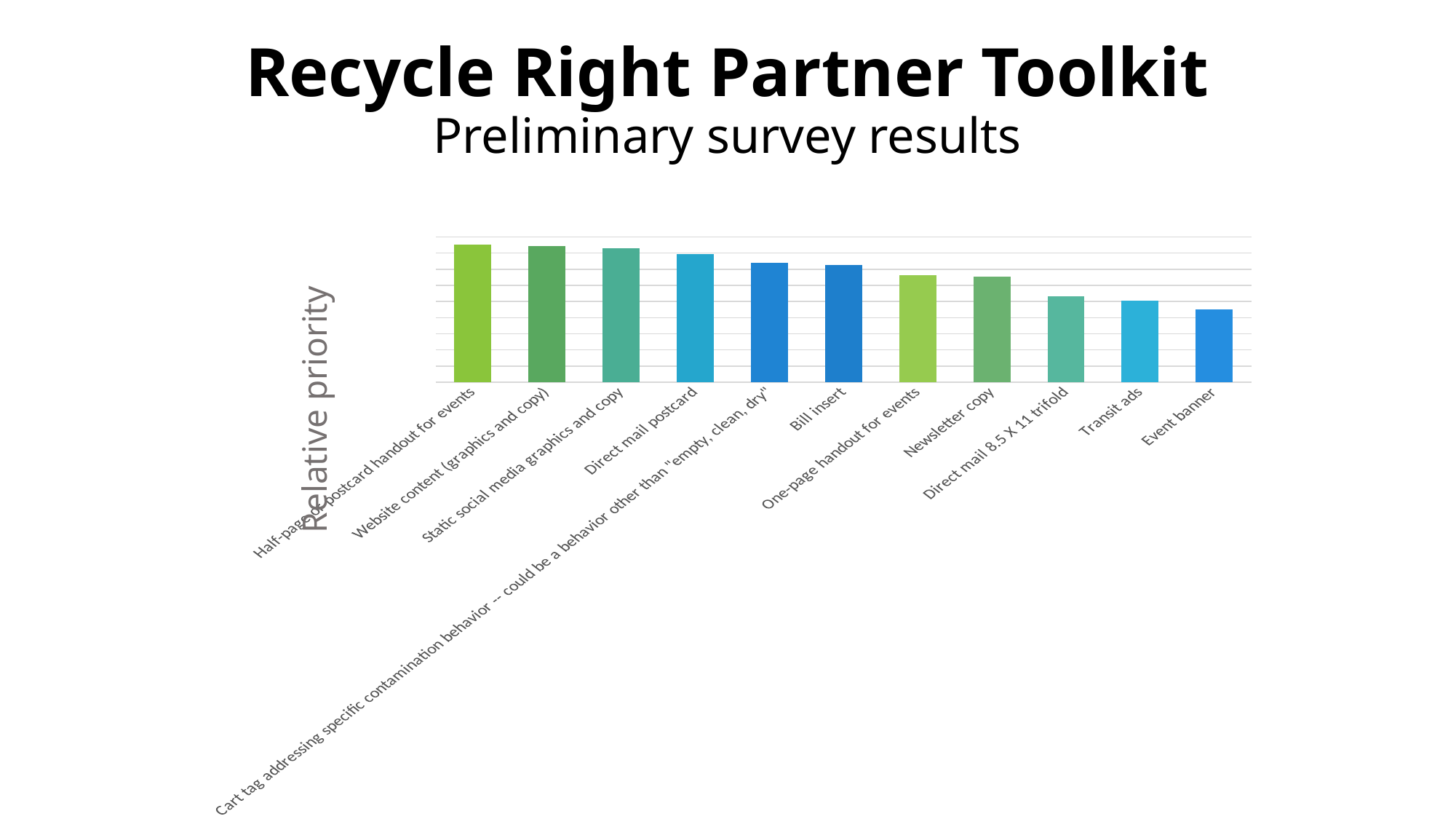
Which category has the lowest relative priority in the chart? Event banner Which has the higher relative priority: One-page handout for events or Direct mail 8.5 X 11 trifold? One-page handout for events Which has the higher relative priority: Direct mail postcard or Bill insert? Direct mail postcard What kind of chart is shown on the slide? Bar chart Which has the higher relative priority: Website content (graphics and copy) or Event banner? Website content (graphics and copy) Do the bar values rise or fall moving from left to right along the x axis? Fall What is the subtitle shown above the chart on the slide? Preliminary survey results How many categories (bars) are plotted in the chart? 11 What is the label on the vertical axis of the chart? Relative priority